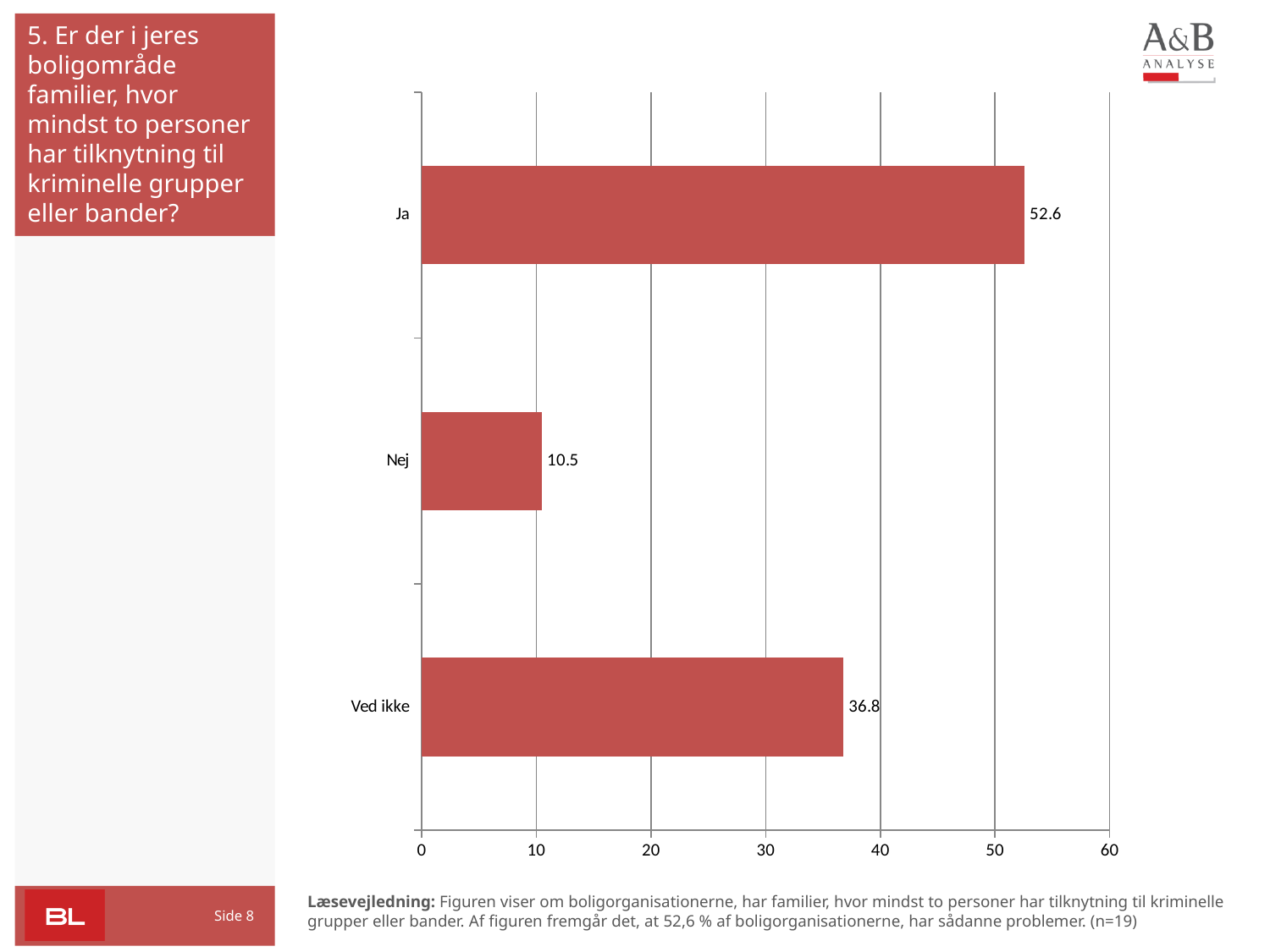
What is the value for Nej? 10.5 Which category has the highest value? Ja What kind of chart is shown on the slide? bar chart Which category has the lowest value? Nej What is the value for Ja? 52.6 What is the highest value shown on the x axis? 60 Which is larger, the value for Ved ikke or the value for Nej? Ved ikke What is the difference between the values for Ja and Ved ikke? 15.8 How many categories are shown in the chart? 3 What is the difference between the values for Ved ikke and Nej? 26.3 Is the value for Ja greater or less than 50? greater What is the value for Ved ikke? 36.8